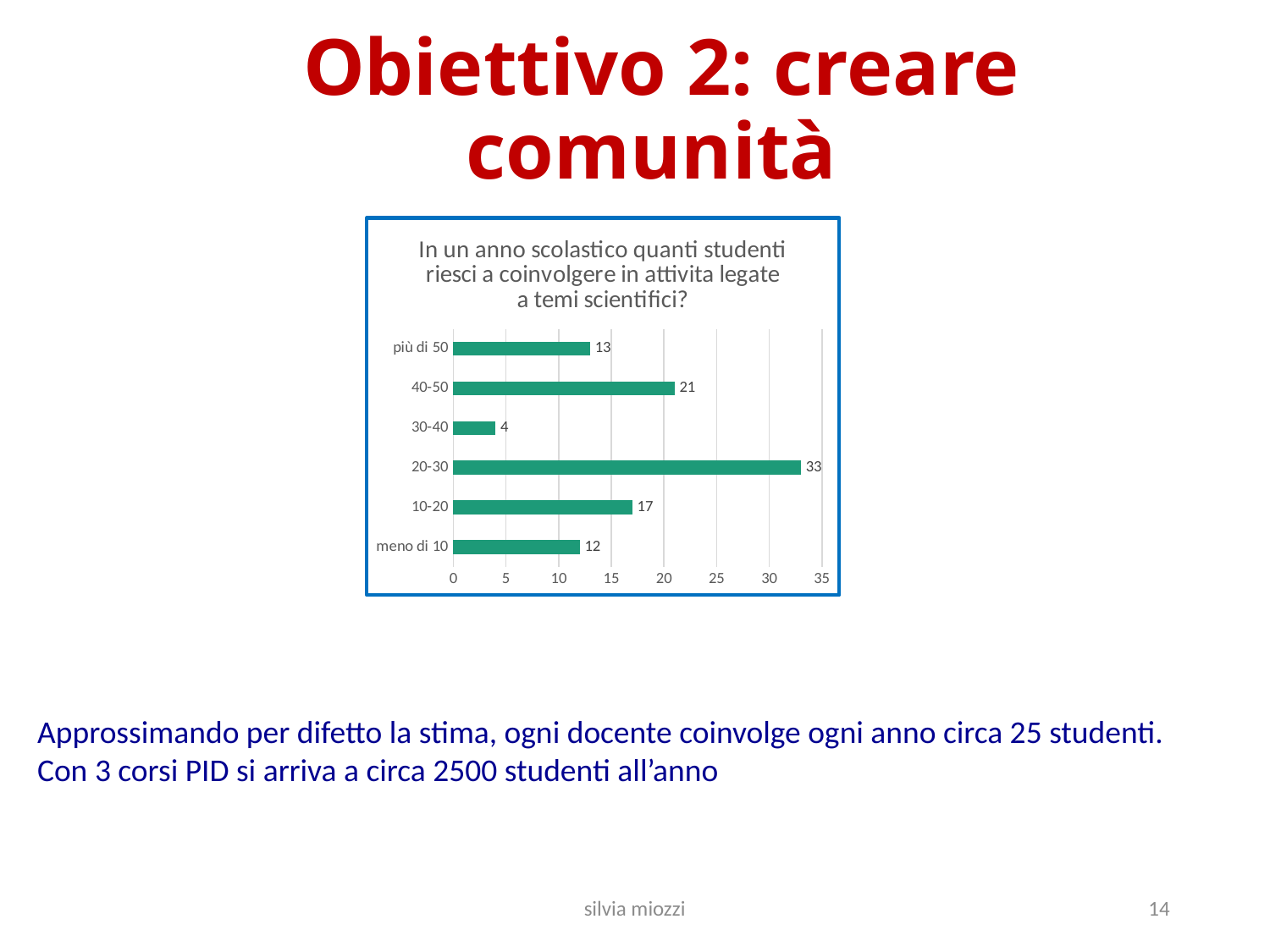
How many categories are shown in the chart? 6 Which category has the lowest value? 30-40 Which is larger, the value for 'più di 50' or the value for '40-50'? 40-50 What is the difference between the values for '20-30' and '10-20'? 16 What is the value for the '40-50' category? 21 What is the value for the 'meno di 10' category? 12 What is the highest value shown on the x axis of the chart? 35 What is the title of the chart? In un anno scolastico quanti studenti riesci a coinvolgere in attivita legate a temi scientifici? What kind of chart is shown on the slide? Bar chart What is the value for the '20-30' category? 33 Which category has the highest value? 20-30 Is the value for '10-20' greater or less than 15? greater